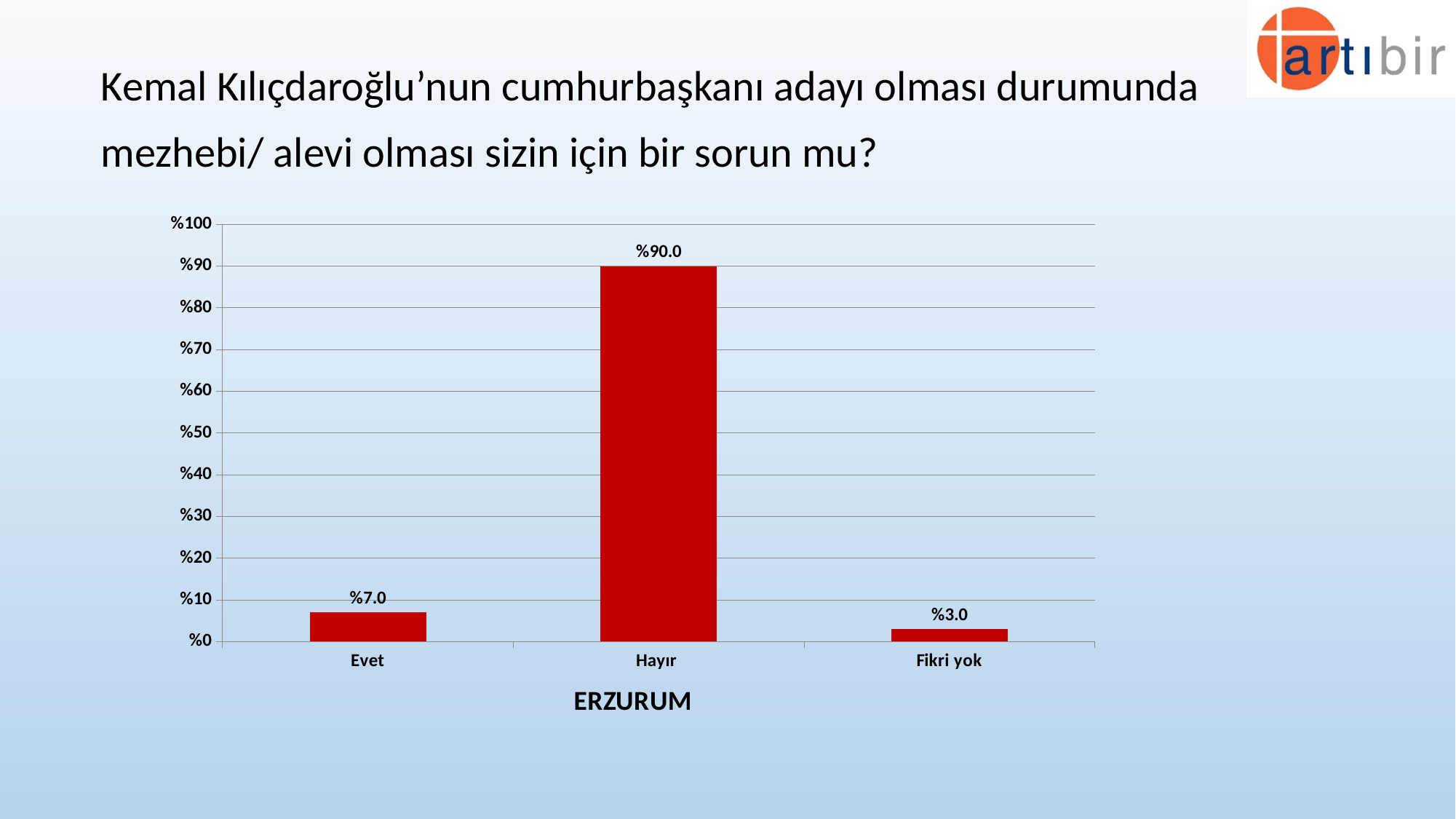
Is the value for Hayır greater or less than %50? greater What is the difference between the values for Evet and Fikri yok? %4.0 What label appears below the x axis of the chart? ERZURUM What is the value for Evet? %7.0 How many categories are shown on the x axis? 3 Which category has the highest value? Hayır What is the value for Fikri yok? %3.0 Which category has the lowest value? Fikri yok What is the value for Hayır? %90.0 Which is larger, the value for Evet or the value for Fikri yok? Evet What is the difference between the values for Hayır and Evet? %83.0 What kind of chart is shown on the slide? bar chart